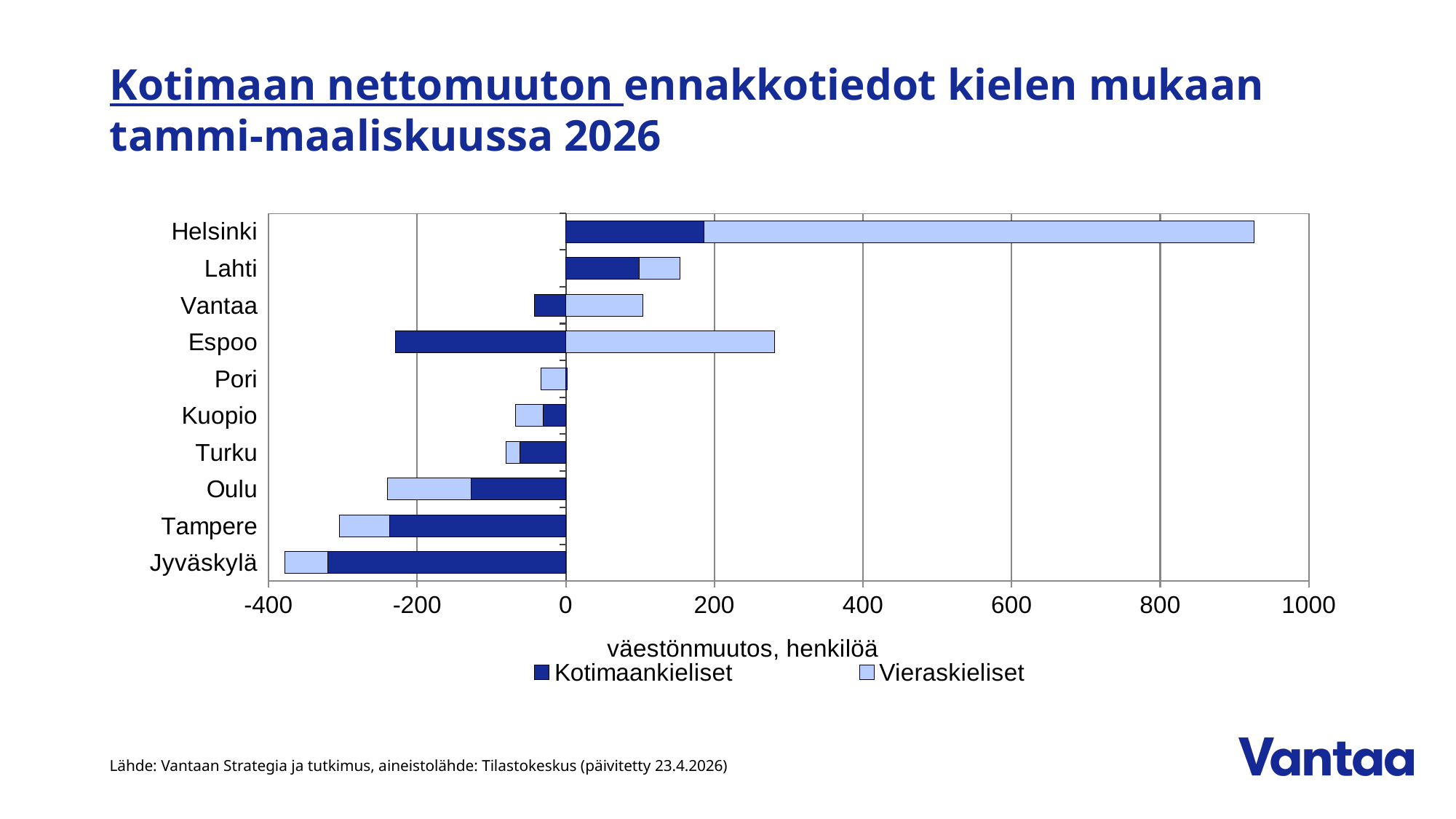
Is the Vieraskieliset value for Espoo greater or less than 200? greater Which is larger, the Vieraskieliset value for Espoo or for Vantaa? Espoo Is the Kotimaankieliset value for Espoo greater or less than -200? less Which city has the largest Vieraskieliset value? Helsinki How many cities are listed on the chart? 10 Is the Vieraskieliset value for Helsinki greater or less than 600? greater How many series does the legend list? 2 What kind of chart is shown on the slide? bar chart What is the title of the horizontal axis? väestönmuutos, henkilöä Which is larger, the Vieraskieliset value for Vantaa or for Lahti? Vantaa Which city has the most negative Kotimaankieliset value? Jyväskylä